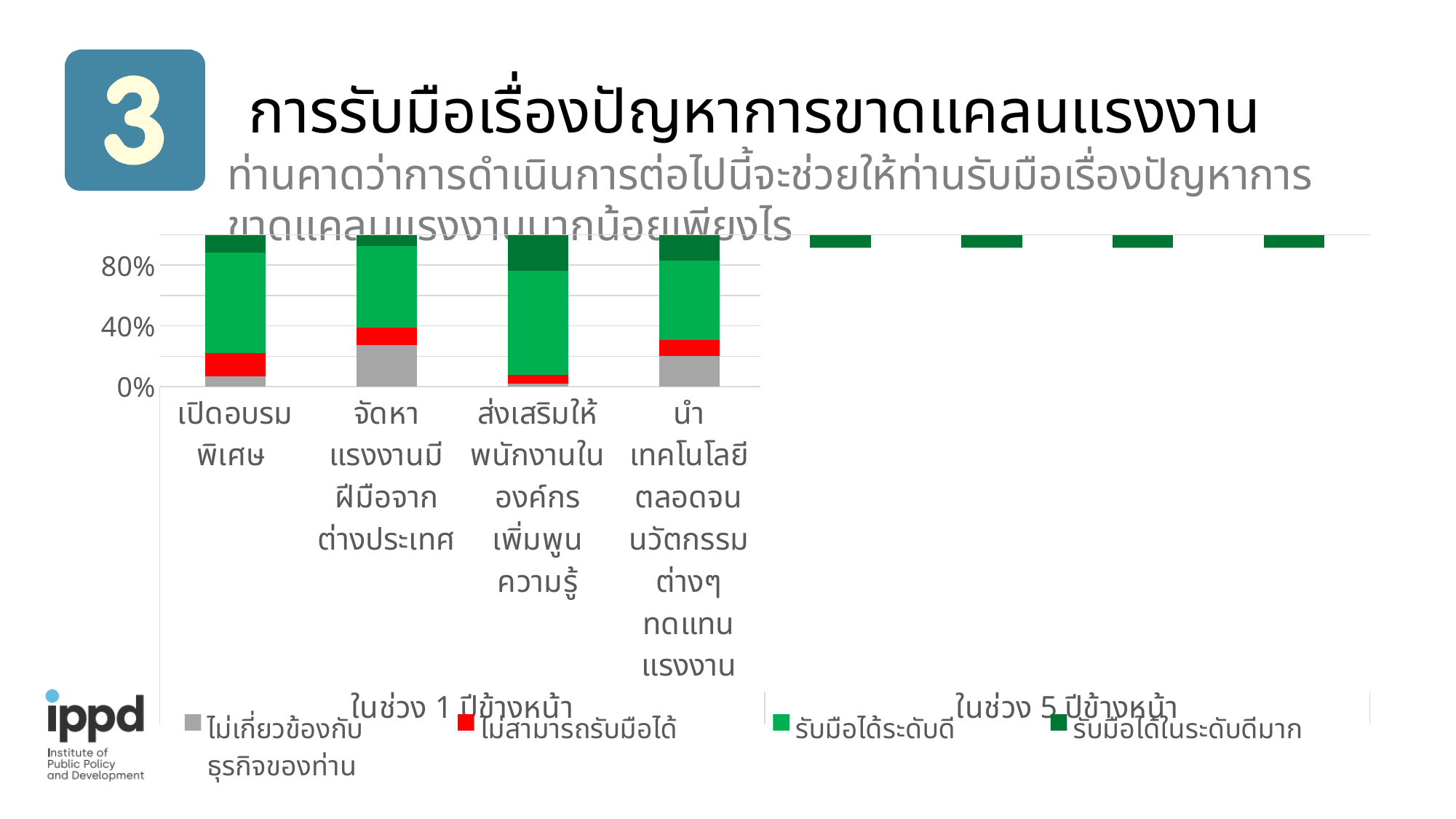
How many series does the legend list? 4 Which category has the largest red (ไม่สามารถรับมือได้) segment? เปิดอบรมพิเศษ Which category has the smallest red (ไม่สามารถรับมือได้) segment? ส่งเสริมให้พนักงานในองค์กรเพิ่มพูนความรู้ Is the grey (ไม่เกี่ยวข้องกับธุรกิจของท่าน) segment larger for จัดหาแรงงานมีฝีมือจากต่างประเทศ or for นำเทคโนโลยีตลอดจนนวัตกรรมต่างๆทดแทนแรงงาน? จัดหาแรงงานมีฝีมือจากต่างประเทศ Is the top of the grey (ไม่เกี่ยวข้องกับธุรกิจของท่าน) segment for จัดหาแรงงานมีฝีมือจากต่างประเทศ greater or less than 40%? less Is the top of the green (รับมือได้ระดับดี) segment for เปิดอบรมพิเศษ greater or less than 80%? greater Which category has the largest dark green (รับมือได้ในระดับดีมาก) segment? ส่งเสริมให้พนักงานในองค์กรเพิ่มพูนความรู้ What kind of chart is shown on the slide? stacked bar chart Is the dark green (รับมือได้ในระดับดีมาก) segment larger for ส่งเสริมให้พนักงานในองค์กรเพิ่มพูนความรู้ or for จัดหาแรงงานมีฝีมือจากต่างประเทศ? ส่งเสริมให้พนักงานในองค์กรเพิ่มพูนความรู้ What colour does the legend use for ไม่สามารถรับมือได้? red Which category has the largest grey (ไม่เกี่ยวข้องกับธุรกิจของท่าน) segment? จัดหาแรงงานมีฝีมือจากต่างประเทศ How many categories are labelled on the x axis of the chart? 4